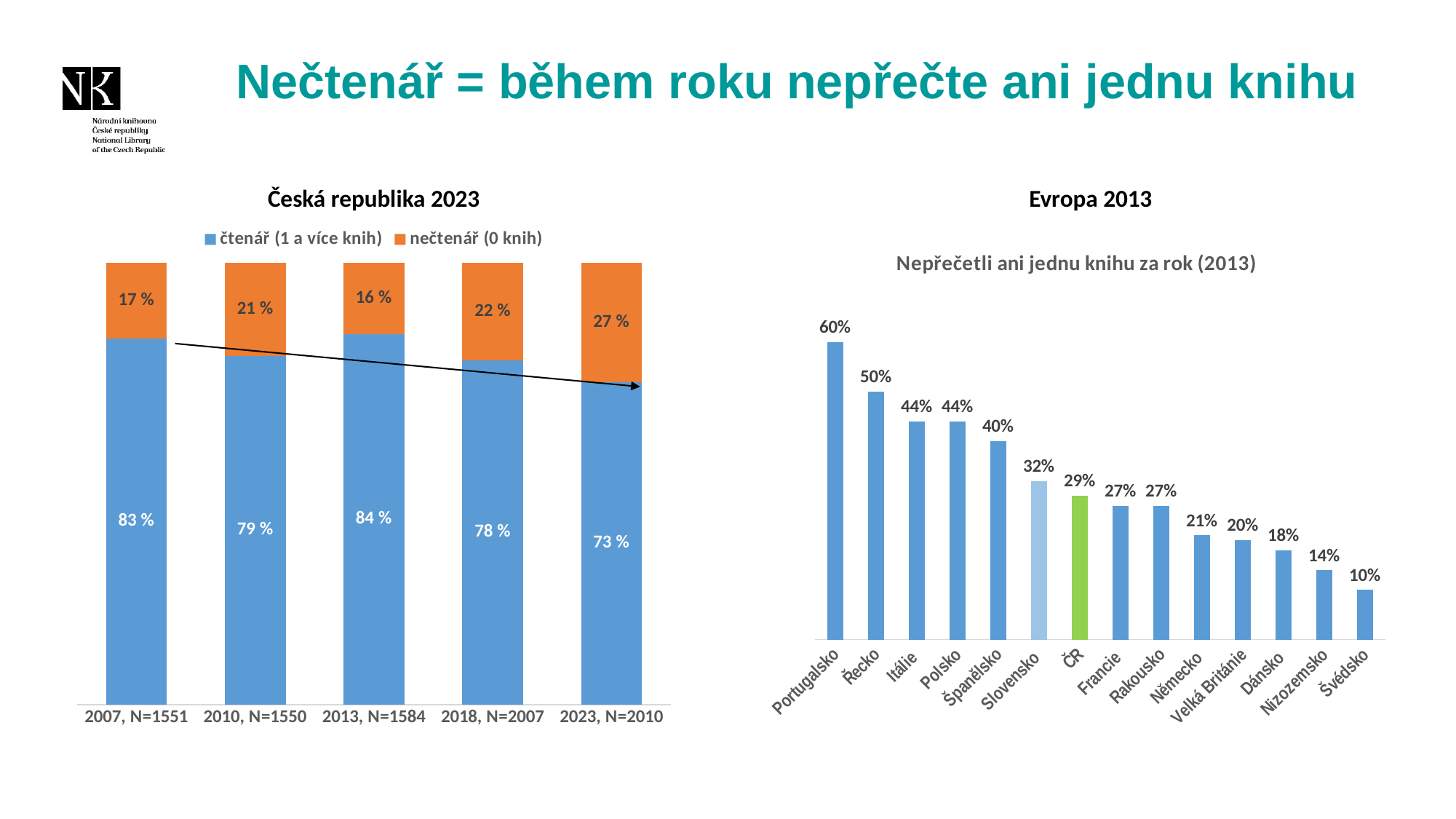
In the 'Česká republika 2023' chart, what is the value for čtenář (1 a více knih) in 2013, N=1584? 84 % In the 'Česká republika 2023' chart, what is the difference between the čtenář share in 2007, N=1551 and in 2023, N=2010? 10 % In the 'Evropa 2013' chart, what is the difference between the values for Slovensko and ČR? 3% In the 'Česká republika 2023' chart, what is the value for nečtenář (0 knih) in 2023, N=2010? 27 % What kind of chart is the 'Evropa 2013' chart? Bar chart In the 'Evropa 2013' chart, which is larger, the value for Německo or the value for Dánsko? Německo In the 'Česká republika 2023' chart, how many series does the legend list? 2 In the 'Evropa 2013' chart, what is the value for ČR? 29% In the 'Česká republika 2023' chart, which year has the lowest share of nečtenář (0 knih)? 2013, N=1584 In the 'Evropa 2013' chart, which country has the lowest value? Švédsko In the 'Česká republika 2023' chart, how many categories are shown on the x axis? 5 In the 'Evropa 2013' chart, which country has the highest value? Portugalsko